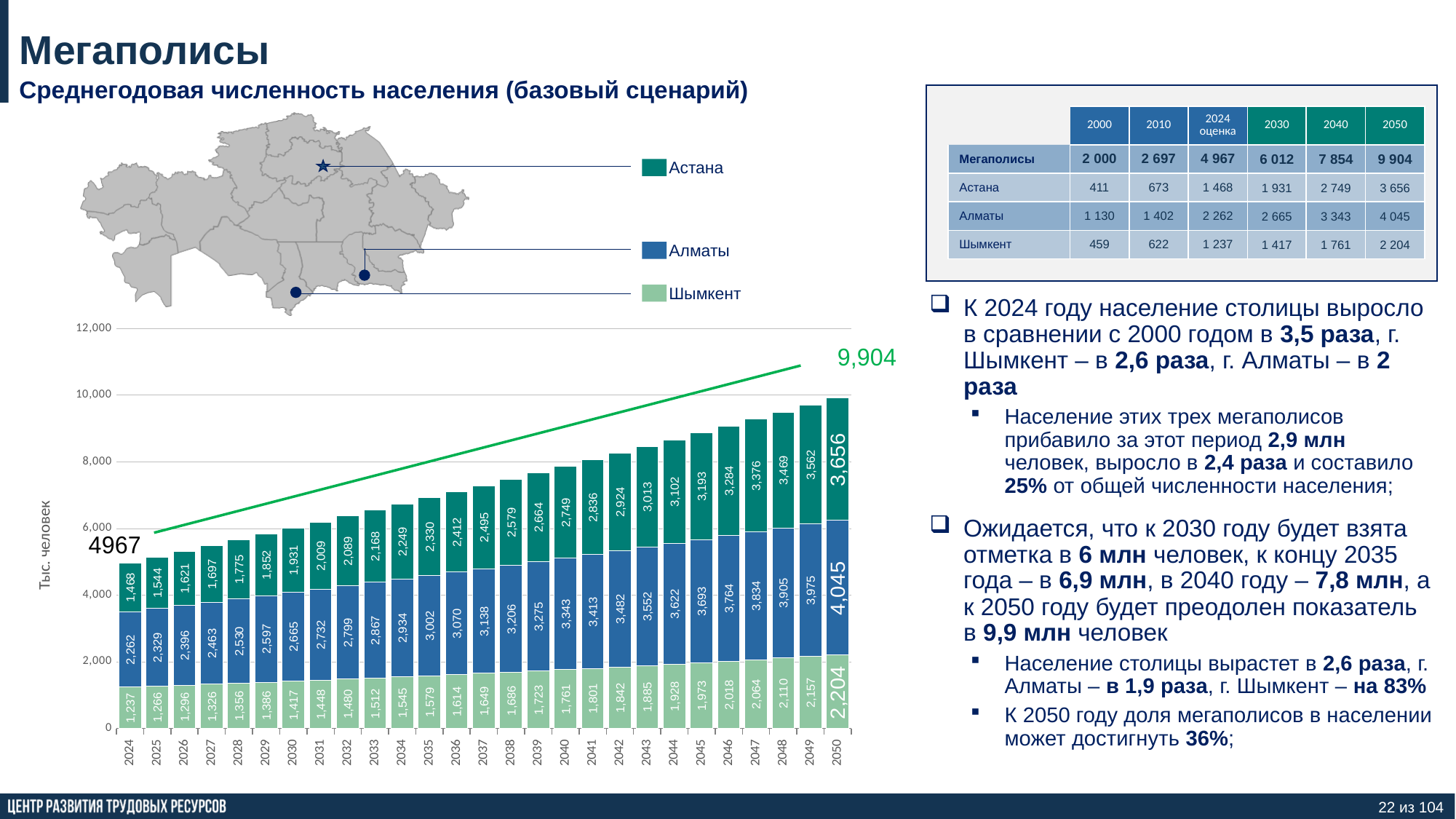
Do the total stacked bar values rise or fall from 2024 to 2050? Rise Which series has the lowest value in 2030? Шымкент What kind of chart is shown on the slide? Stacked bar chart with a line (combination chart) What is the difference between the Алматы and Астана values in 2050? 389 What is the value for Алматы in 2040 on the chart? 3,343 How many series does the chart legend list? 3 What is the value for Шымкент in 2050 on the chart? 2,204 Which series has the highest value in 2050? Алматы What is the value for Астана in 2024 on the chart? 1,468 Which is larger in 2024: the value for Алматы or the value for Астана? Алматы How many years (bars) are plotted along the x axis of the chart? 27 What is the total of the stacked bar for 2024? 4967